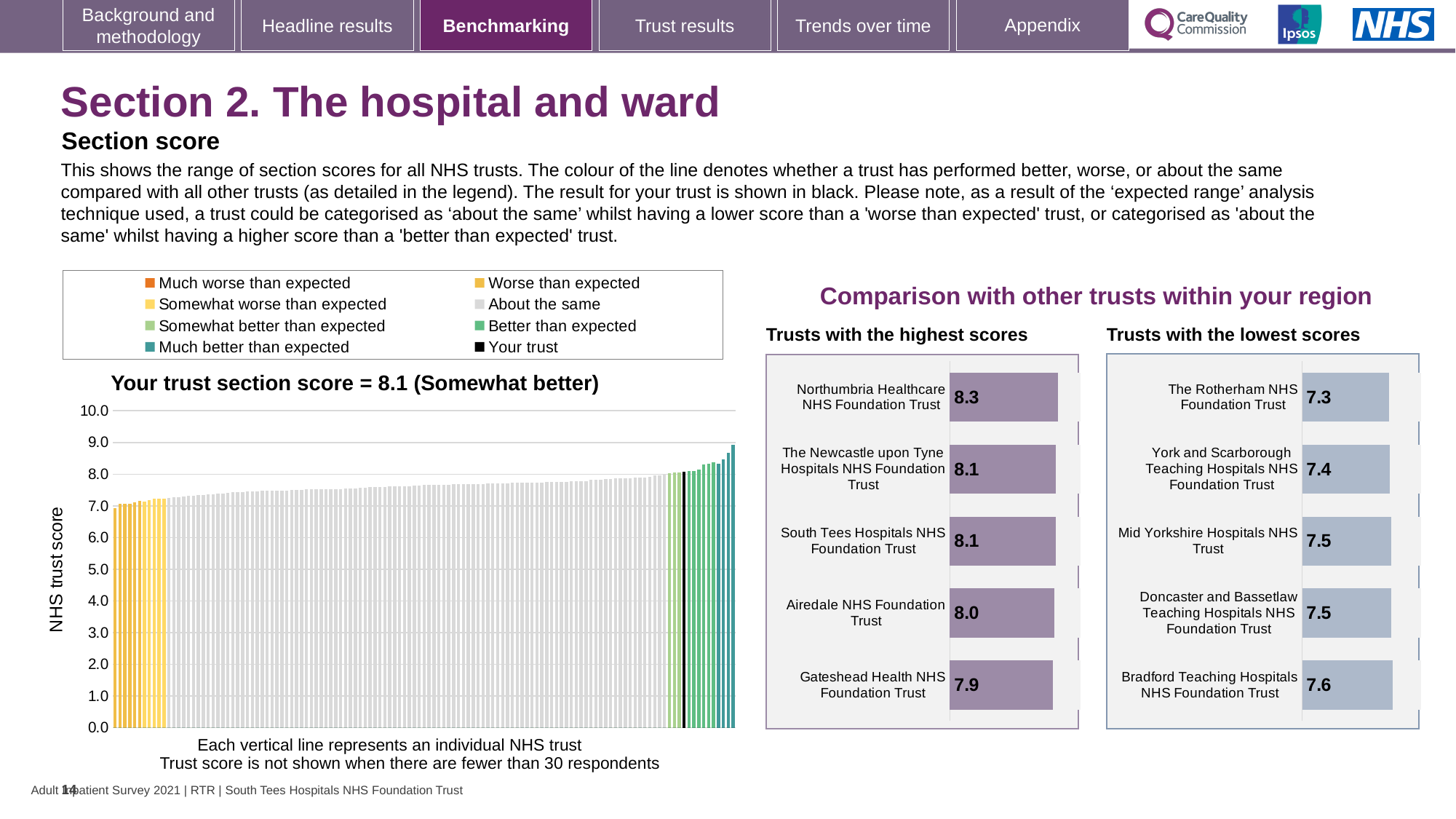
In the 'Trusts with the highest scores' chart, what is the difference between the scores of Northumbria Healthcare NHS Foundation Trust and Gateshead Health NHS Foundation Trust? 0.4 In the 'Trusts with the highest scores' chart, which trust has the highest score? Northumbria Healthcare NHS Foundation Trust What kind of chart is the 'Your trust section score' chart? Bar chart In the 'Trusts with the highest scores' chart, what is the score for Northumbria Healthcare NHS Foundation Trust? 8.3 In the 'Trusts with the lowest scores' chart, which has the larger score: York and Scarborough Teaching Hospitals NHS Foundation Trust or Bradford Teaching Hospitals NHS Foundation Trust? Bradford Teaching Hospitals NHS Foundation Trust In the 'Trusts with the lowest scores' chart, which trust has the lowest score? The Rotherham NHS Foundation Trust In the 'Trusts with the lowest scores' chart, what is the difference between the scores of Bradford Teaching Hospitals NHS Foundation Trust and The Rotherham NHS Foundation Trust? 0.3 In the 'Trusts with the lowest scores' chart, what is the score for The Rotherham NHS Foundation Trust? 7.3 In the 'Trusts with the highest scores' chart, what is the score for Gateshead Health NHS Foundation Trust? 7.9 In the 'Your trust section score' chart, what is the section score for your trust? 8.1 In the 'Trusts with the highest scores' chart, how many trusts are listed? 5